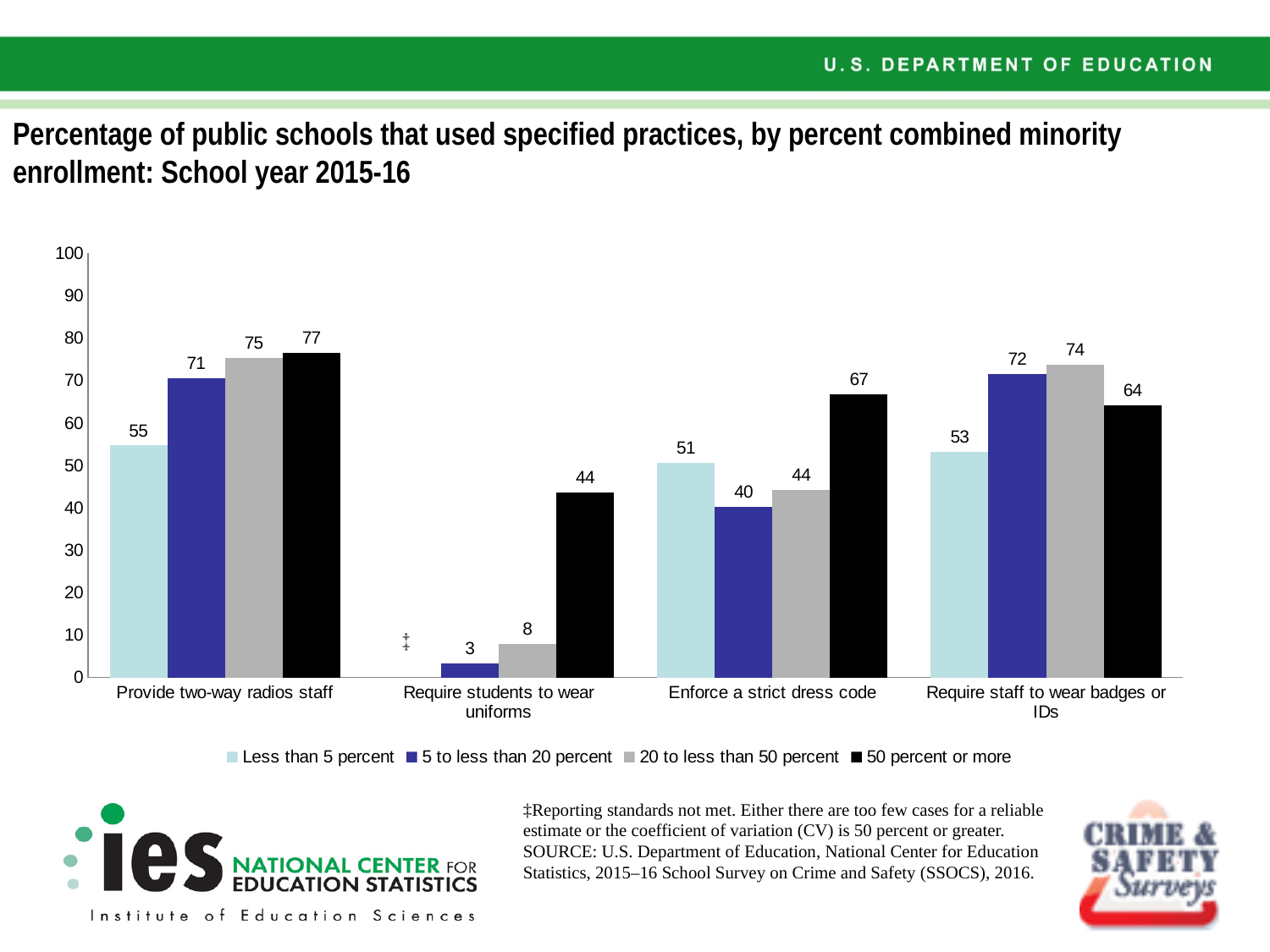
What percentage of public schools with 50 percent or more minority enrollment provided two-way radios to staff? 77 Which minority enrollment group has the lowest value for 'Enforce a strict dress code'? 5 to less than 20 percent Which minority enrollment group has the highest value for 'Require staff to wear badges or IDs'? 20 to less than 50 percent What colour represents the '50 percent or more' series? Black What is the difference between the 50 percent or more and the less than 5 percent values for 'Provide two-way radios staff'? 22 How many practice categories are shown on the x axis? 4 What is the value for 'Require students to wear uniforms' among schools with 20 to less than 50 percent minority enrollment? 8 For 'Require staff to wear badges or IDs', which is larger: the value for 5 to less than 20 percent or the value for 50 percent or more? 5 to less than 20 percent What kind of chart is shown on the slide? Bar chart Which category has a bar marked with the ‡ symbol instead of a value? Require students to wear uniforms What is the value for 'Enforce a strict dress code' among schools with less than 5 percent minority enrollment? 51 How many series does the legend list? 4